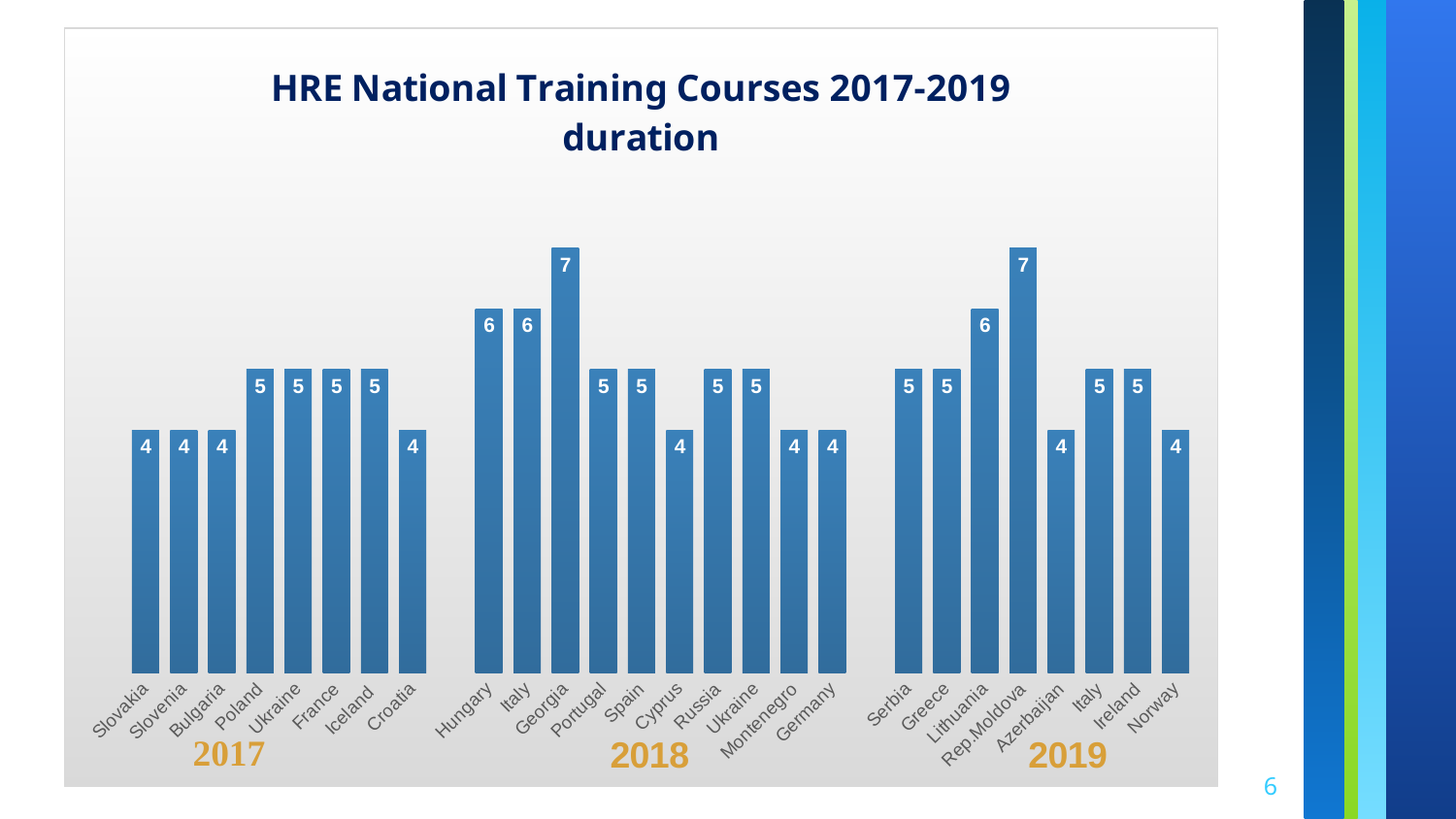
What is the duration value for Lithuania in the 2019 group? 6 How many countries are shown in the 2018 group? 10 What is the duration value for Georgia in the 2018 group? 7 What is the difference between the duration values for Georgia (2018) and Cyprus (2018)? 3 What is the duration value for Poland in the 2017 group? 5 Which country has the highest duration value in the 2018 group? Georgia What is the duration value for Rep.Moldova in the 2019 group? 7 What is the duration value for Ukraine in the 2018 group? 5 Which has a larger duration value: Hungary (2018) or Serbia (2019)? Hungary What type of chart is shown on the slide? Bar chart Which country has the highest duration value in the 2019 group? Rep.Moldova How many bars are plotted in total across all three years? 26